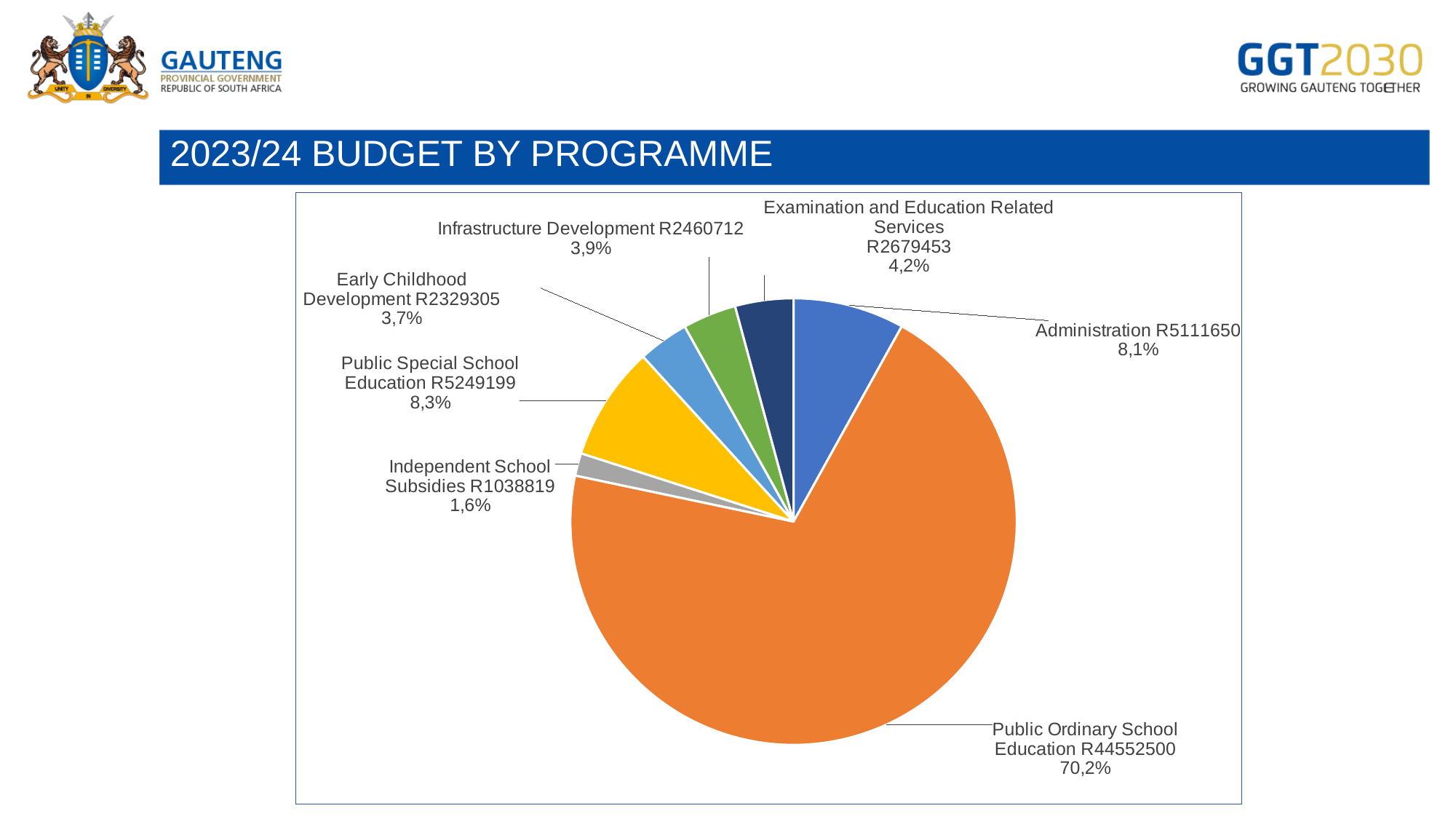
Which programme has the largest share of the budget? Public Ordinary School Education Which programme has the smallest share of the budget? Independent School Subsidies How many programmes are shown in the pie chart? 7 What is the budget value for Independent School Subsidies? R1038819 What share of the budget does Administration represent? 8,1% What is the difference between the budget for Examination and Education Related Services and Infrastructure Development? R218741 Which is larger, the budget for Public Special School Education or for Administration? Public Special School Education What percentage share does Early Childhood Development have? 3,7% What is the budget value for Public Ordinary School Education? R44552500 What is the budget value for Infrastructure Development? R2460712 What type of chart is shown on the slide? Pie chart What is the title of the slide containing the chart? 2023/24 BUDGET BY PROGRAMME